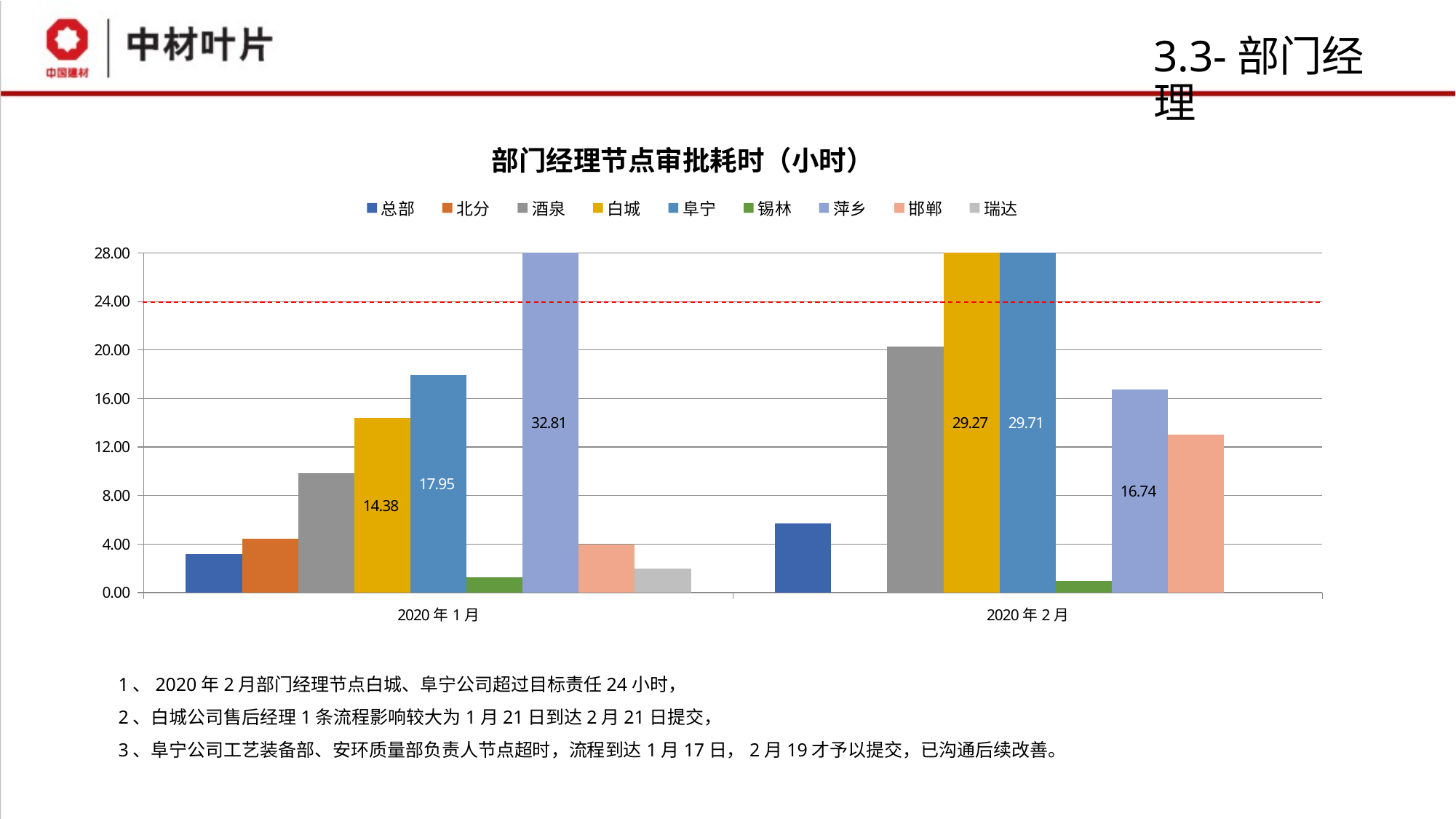
What kind of chart is shown on the slide? bar chart What is the difference between the values for 阜宁 and 白城 in 2020年2月? 0.44 By how much did the value for 白城 increase from 2020年1月 to 2020年2月? 14.89 What is the value for 萍乡 in 2020年2月? 16.74 What is the value for 萍乡 in 2020年1月? 32.81 What is the value for 阜宁 in 2020年2月? 29.71 Is the value for 酒泉 in 2020年2月 greater or less than 16.00? greater In 2020年2月, which is larger: 阜宁 or 白城? 阜宁 How many series does the legend list? 9 What is the value for 白城 in 2020年1月? 14.38 How many categories are shown on the x axis? 2 Which series has the highest value in 2020年1月? 萍乡